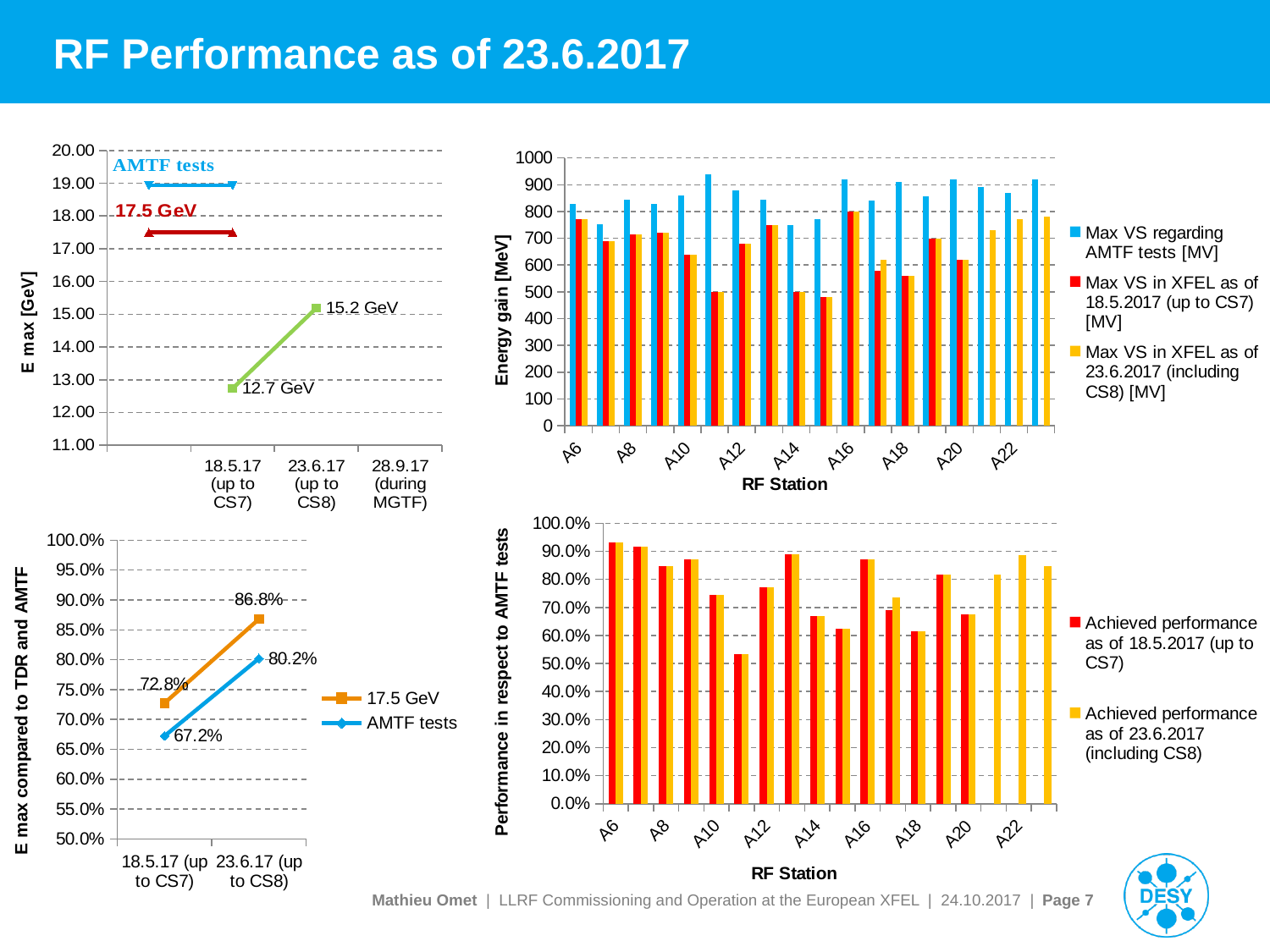
In the top-right chart (Energy gain [MeV]), is the value of 'Max VS in XFEL as of 18.5.2017 (up to CS7)' for A14 greater or less than 600? less In the bottom-left chart (E max compared to TDR and AMTF), what is the value of the AMTF tests series at 18.5.17 (up to CS7)? 67.2% In the top-left chart (E max [GeV]), what is the value at 18.5.17 (up to CS7)? 12.7 GeV In the bottom-left chart (E max compared to TDR and AMTF), what is the difference between the 17.5 GeV series values at 23.6.17 and 18.5.17? 14.0% In the top-left chart (E max [GeV]), what is the value at 23.6.17 (up to CS8)? 15.2 GeV In the top-left chart (E max [GeV]), by how much does E max increase from 18.5.17 to 23.6.17? 2.5 GeV In the bottom-right chart (Performance in respect to AMTF tests), is the 'Achieved performance as of 18.5.2017 (up to CS7)' value for A6 greater or less than 90.0%? greater In the bottom-left chart (E max compared to TDR and AMTF), how many series does the legend list? 2 In the bottom-left chart (E max compared to TDR and AMTF), which series has the larger value at 23.6.17 (up to CS8)? 17.5 GeV In the bottom-left chart (E max compared to TDR and AMTF), what is the value of the 17.5 GeV series at 23.6.17 (up to CS8)? 86.8% What kind of chart is the top-right chart (Energy gain [MeV] by RF Station)? bar chart In the top-right chart (Energy gain [MeV]), how many series does the legend list? 3